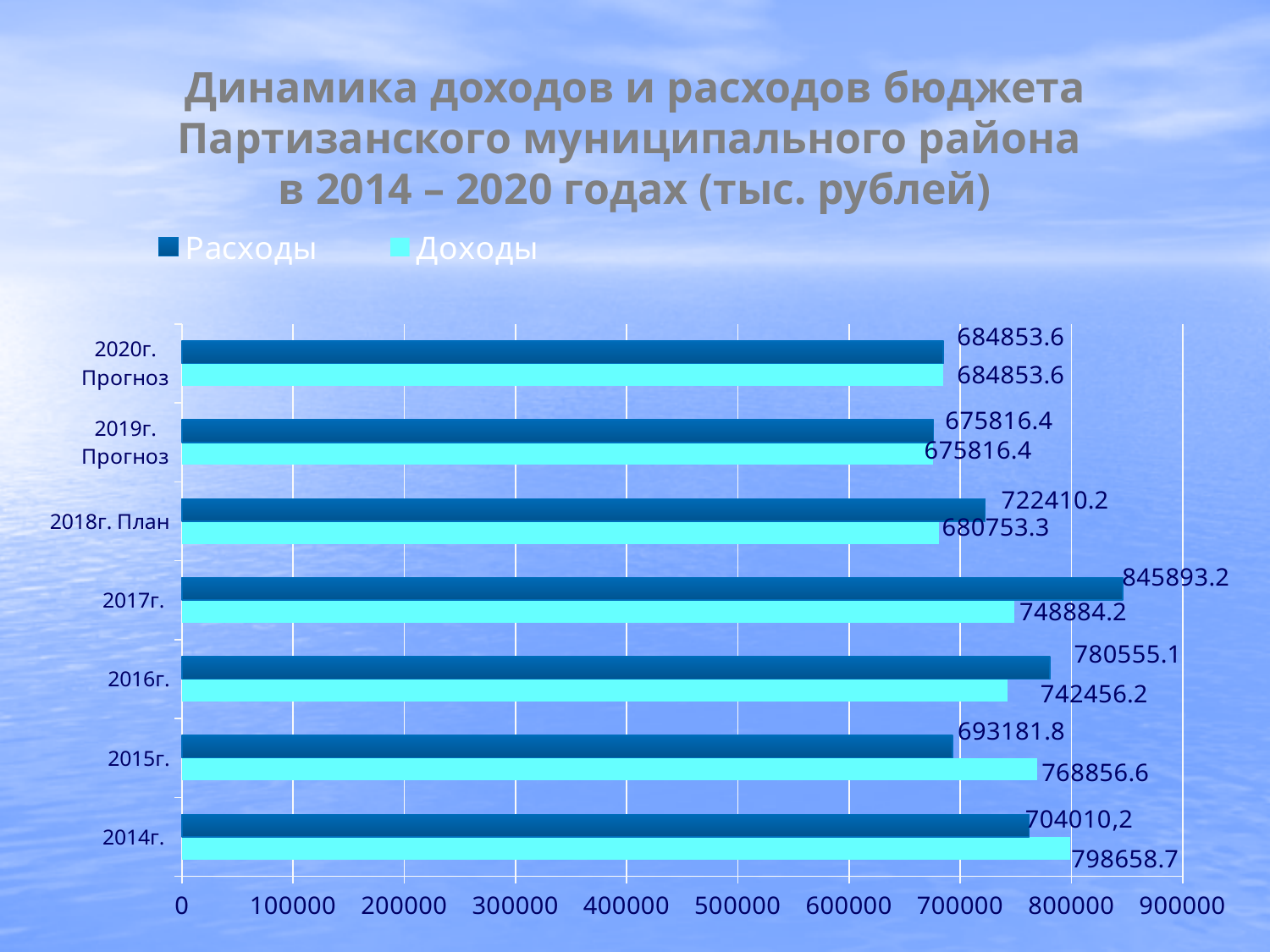
What is the value of Расходы for 2017г.? 845893.2 What is the value of Расходы for 2015г.? 693181.8 What is the difference between Расходы and Доходы for 2018г. План? 41656.9 What is the value of Доходы for 2014г.? 798658.7 Which series is shown in dark blue according to the legend? Расходы Which category has the lowest Доходы value? 2019г. Прогноз What is the value of Доходы for 2018г. План? 680753.3 How many series does the legend list? 2 What kind of chart is shown on the slide? Bar chart Which category has the highest Расходы value? 2017г. How many categories (years) are shown on the chart? 7 Which is larger for 2015г., Расходы or Доходы? Доходы